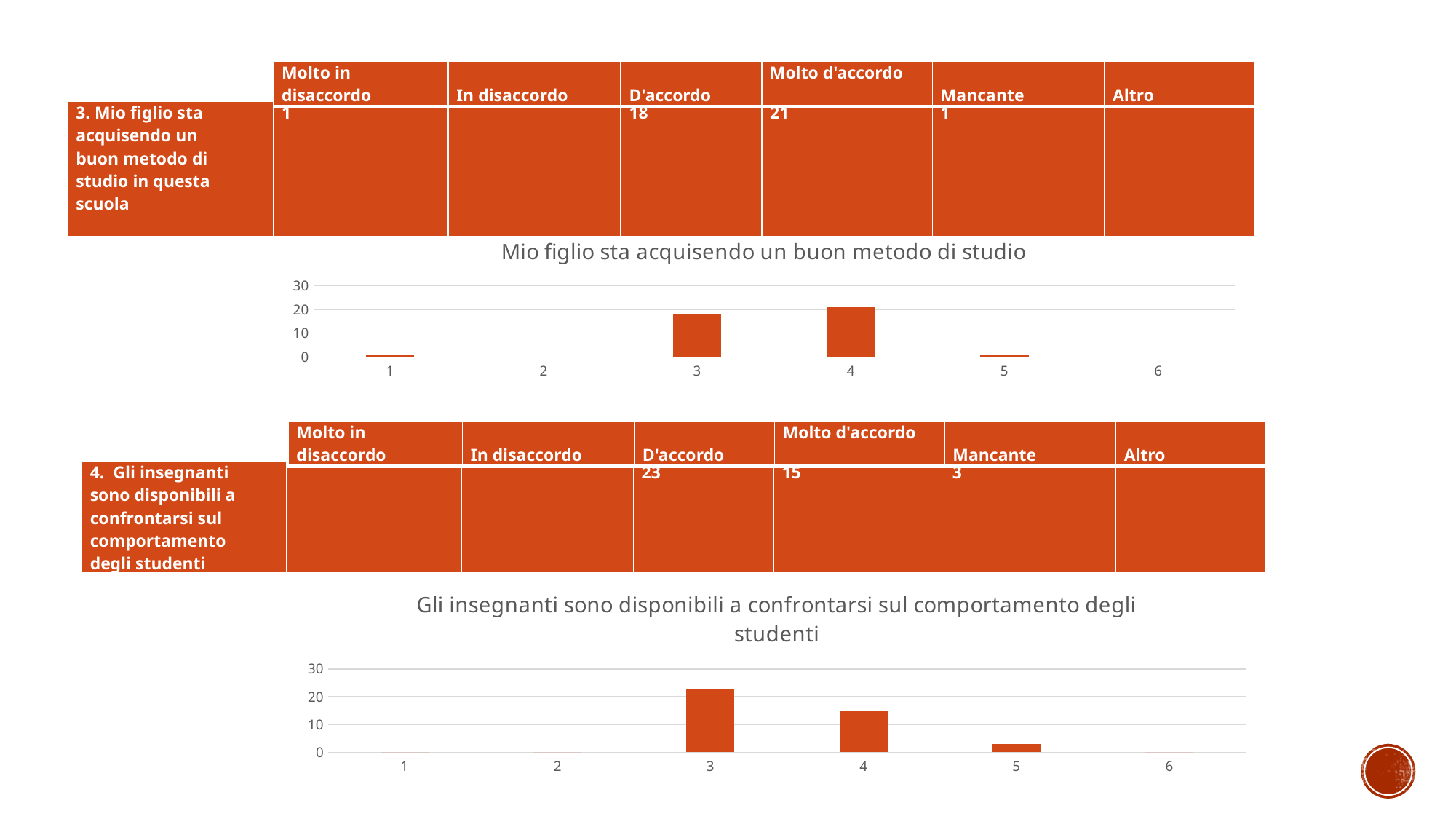
According to the table above the top chart, how many respondents answered "Molto d'accordo" to "Mio figlio sta acquisendo un buon metodo di studio in questa scuola"? 21 In the bottom chart "Gli insegnanti sono disponibili a confrontarsi sul comportamento degli studenti", is the bar for category 3 taller than the bar for category 4? Yes In the top chart "Mio figlio sta acquisendo un buon metodo di studio", which category has the tallest bar? 4 What is the title of the bottom chart on the slide? Gli insegnanti sono disponibili a confrontarsi sul comportamento degli studenti In the top chart "Mio figlio sta acquisendo un buon metodo di studio", how many categories are shown on the x axis? 6 In the bottom chart "Gli insegnanti sono disponibili a confrontarsi sul comportamento degli studenti", which category has the tallest bar? 3 According to the table above the bottom chart, how many respondents answered "D'accordo" to "Gli insegnanti sono disponibili a confrontarsi sul comportamento degli studenti"? 23 According to the table above the top chart, what is the difference between the "Molto d'accordo" and "D'accordo" counts for "Mio figlio sta acquisendo un buon metodo di studio in questa scuola"? 3 In the bottom chart "Gli insegnanti sono disponibili a confrontarsi sul comportamento degli studenti", is the value for category 3 greater or less than 20? greater What kind of chart is the top chart titled "Mio figlio sta acquisendo un buon metodo di studio"? bar chart According to the table above the bottom chart, what is the difference between the "D'accordo" and "Molto d'accordo" counts for "Gli insegnanti sono disponibili a confrontarsi sul comportamento degli studenti"? 8 In the top chart "Mio figlio sta acquisendo un buon metodo di studio", is the value for category 3 greater or less than 10? greater